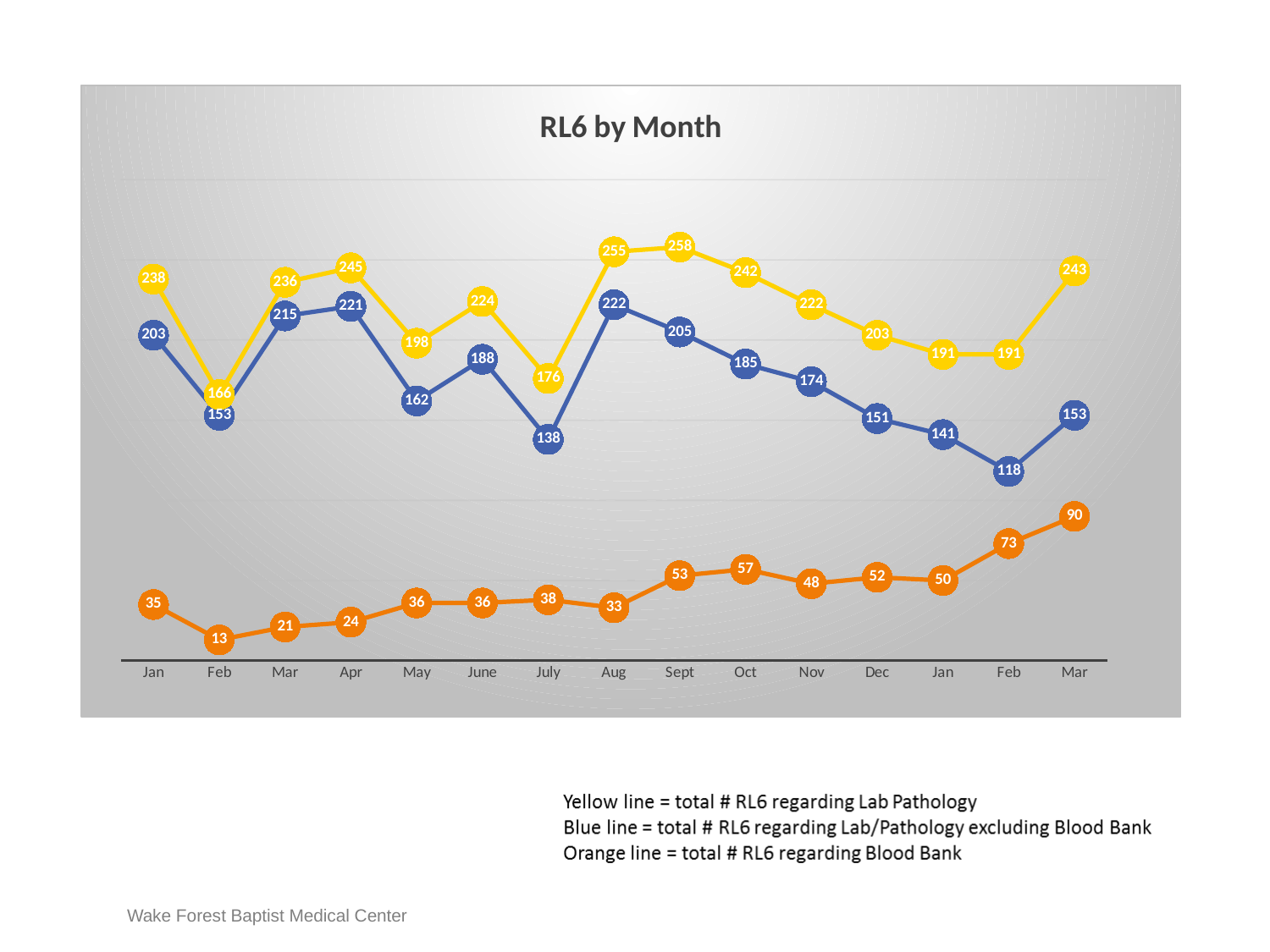
What is the value of the blue line in Aug? 222 How many months are shown along the x axis? 15 What is the difference between the yellow line and the blue line in July? 38 What type of chart is shown on the slide? line chart On the orange line, which is larger, the value for Nov or the value for Dec? Dec What is the value of the yellow line in Sept? 258 What is the value of the orange line in Oct? 57 What is the title of the chart? RL6 by Month What is the lowest value on the blue line? 118 In which month does the yellow line reach its highest value? Sept How many lines are plotted on the chart? 3 According to the text below the chart, what does the orange line represent? total # RL6 regarding Blood Bank